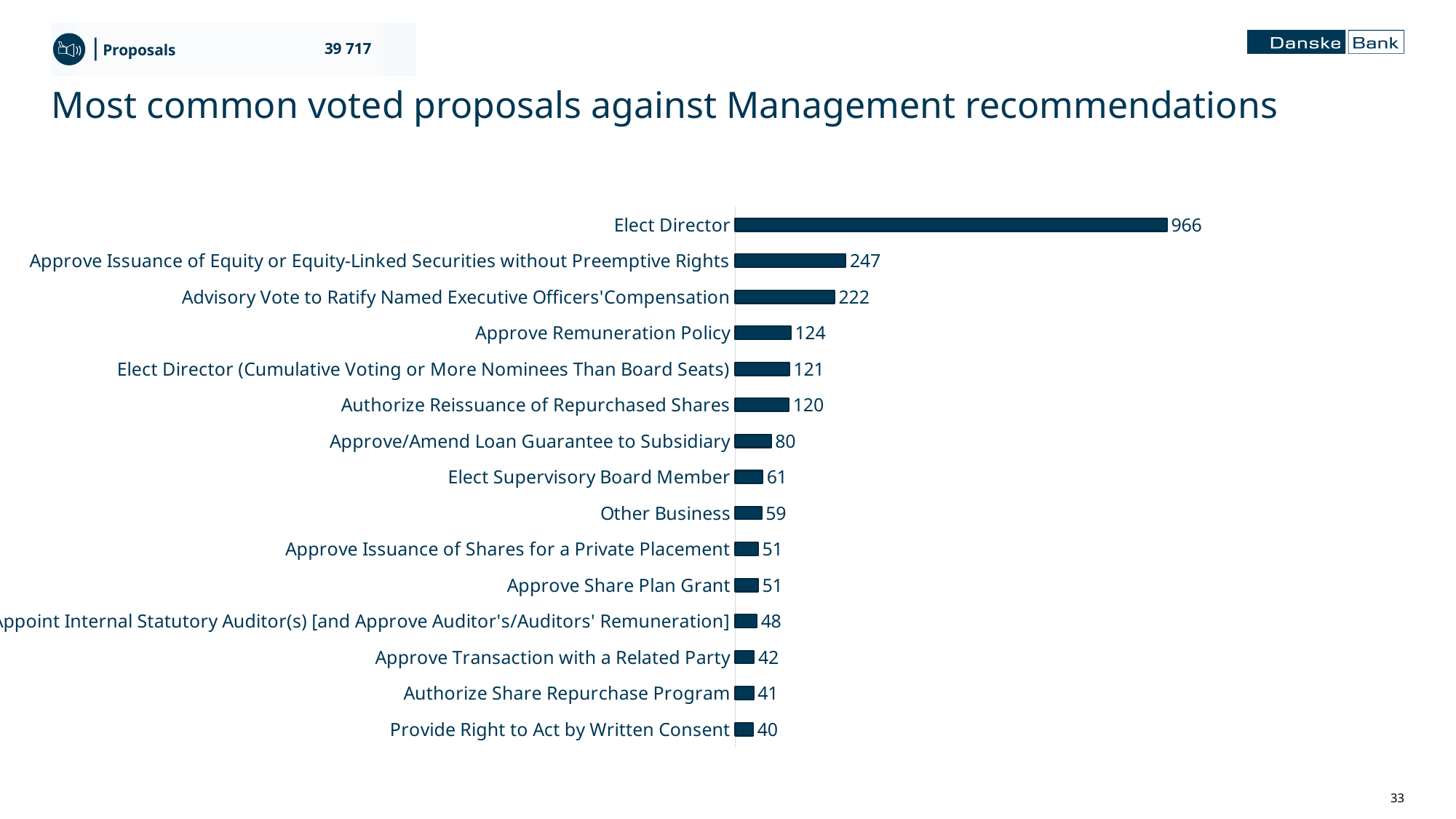
How many categories are shown in the chart? 15 What is the value for Authorize Share Repurchase Program? 41 What is the difference between the values for Advisory Vote to Ratify Named Executive Officers' Compensation and Approve Remuneration Policy? 98 What is the value for Approve Remuneration Policy? 124 What is the value for Elect Director? 966 Which category has the highest value? Elect Director What kind of chart is shown on the slide? Bar chart What is the title of the slide? Most common voted proposals against Management recommendations What is the difference between the values for Elect Director and Approve Issuance of Equity or Equity-Linked Securities without Preemptive Rights? 719 Which category has the lowest value? Provide Right to Act by Written Consent Which is larger, the value for Approve/Amend Loan Guarantee to Subsidiary or the value for Elect Supervisory Board Member? Approve/Amend Loan Guarantee to Subsidiary What is the value for Other Business? 59